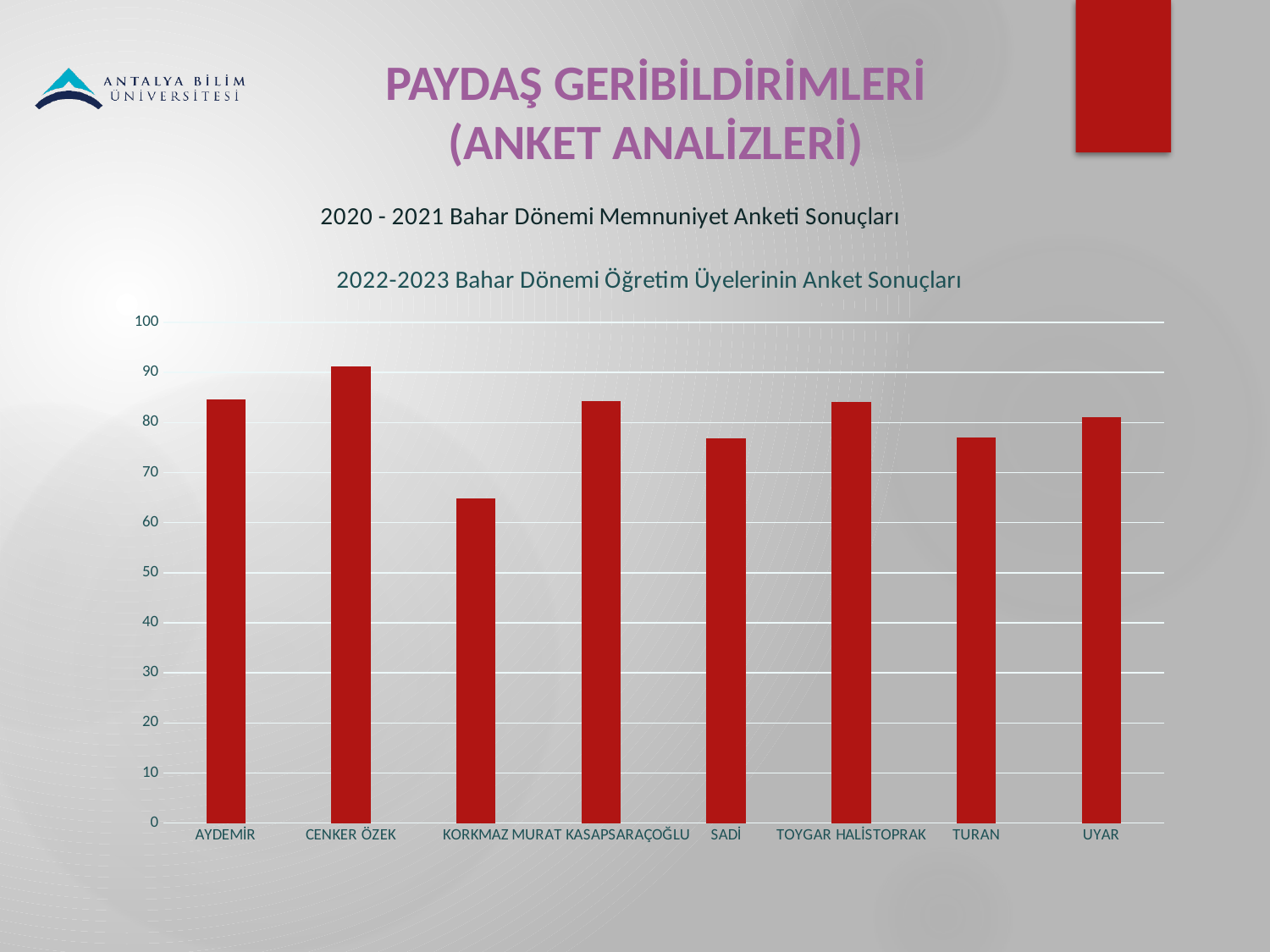
Which is larger, the value for CENKER ÖZEK or the value for UYAR? CENKER ÖZEK Is the value for AYDEMİR greater or less than 80? greater Which is larger, the value for KORKMAZ or the value for TURAN? TURAN What colour are the bars in the chart? red What is the title of the chart? 2022-2023 Bahar Dönemi Öğretim Üyelerinin Anket Sonuçları Is the value for CENKER ÖZEK greater or less than 90? greater Which category has the lowest bar? KORKMAZ Is the value for KORKMAZ greater or less than 70? less What kind of chart is shown on the slide? bar chart How many categories are shown on the x axis of the chart? 8 Which category has the highest bar? CENKER ÖZEK